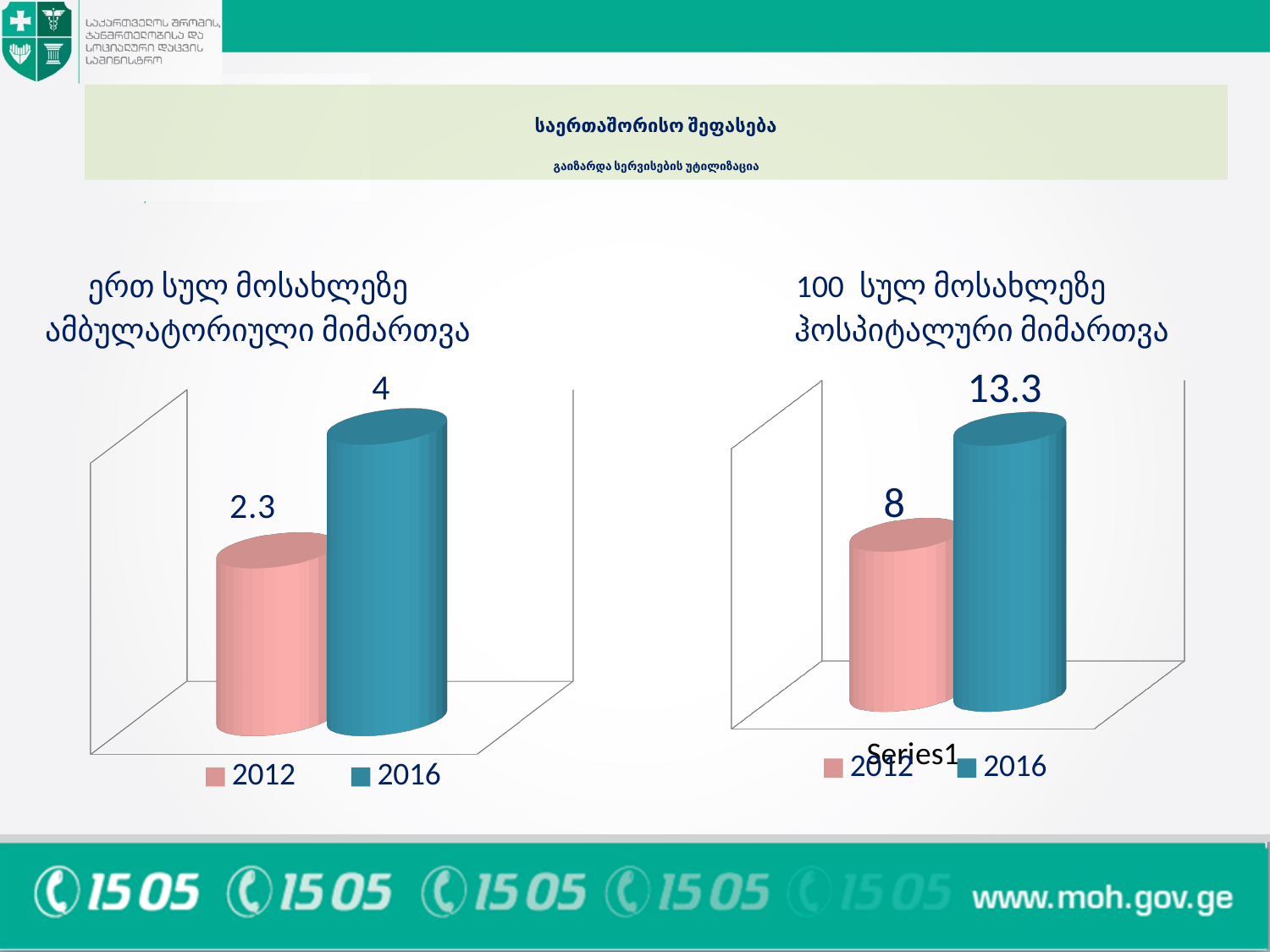
In the left chart, which year has the lowest value? 2012 In the right chart (100 სულ მოსახლეზე ჰოსპიტალური მიმართვა), what is the value for 2016? 13.3 How many bars are plotted in the left chart? 2 How many entries does the legend of the left chart list? 2 In the right chart, which year has the higher value, 2012 or 2016? 2016 In the right chart (100 სულ მოსახლეზე ჰოსპიტალური მიმართვა), what is the value for 2012? 8 In the right chart, which year has the highest value? 2016 In the left chart, by how much did the value increase from 2012 to 2016? 1.7 In the left chart (ერთ სულ მოსახლეზე ამბულატორიული მიმართვა), what is the value for 2016? 4 What type of chart is the right chart? Bar chart In the left chart (ერთ სულ მოსახლეზე ამბულატორიული მიმართვა), what is the value for 2012? 2.3 In the right chart, what is the difference between the 2016 and 2012 values? 5.3